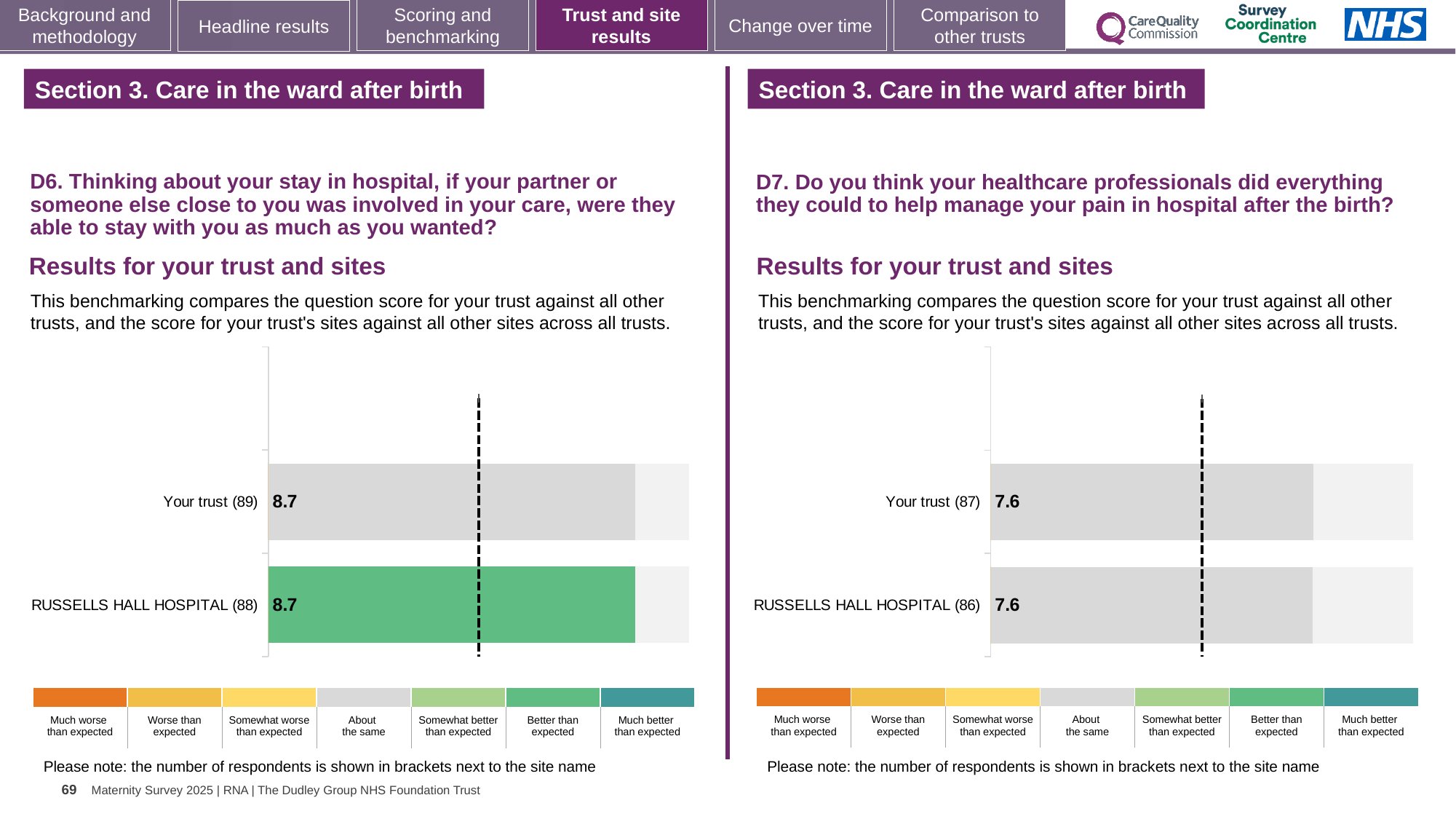
In the D6 chart on the left, what is the score for RUSSELLS HALL HOSPITAL? 8.7 In the D7 chart on the right, what is the score for Your trust? 7.6 How many bars are plotted in the D7 chart on the right? 2 How many bars are plotted in the D6 chart on the left? 2 In the D6 chart on the left, what is the difference between the score for Your trust and the score for RUSSELLS HALL HOSPITAL? 0 In the D7 chart on the right, what is the score for RUSSELLS HALL HOSPITAL? 7.6 In the D6 chart on the left, which benchmark category does the green colour of the RUSSELLS HALL HOSPITAL bar correspond to in the legend? Better than expected In the D7 chart on the right, what is the difference between the score for Your trust and the score for RUSSELLS HALL HOSPITAL? 0 What kind of chart is used for the D6 results on the left? Bar chart In the D6 chart on the left, what is the score for Your trust? 8.7 In the D6 chart on the left, how many respondents are shown in brackets for RUSSELLS HALL HOSPITAL? 88 In the D7 chart on the right, how many respondents are shown in brackets for Your trust? 87